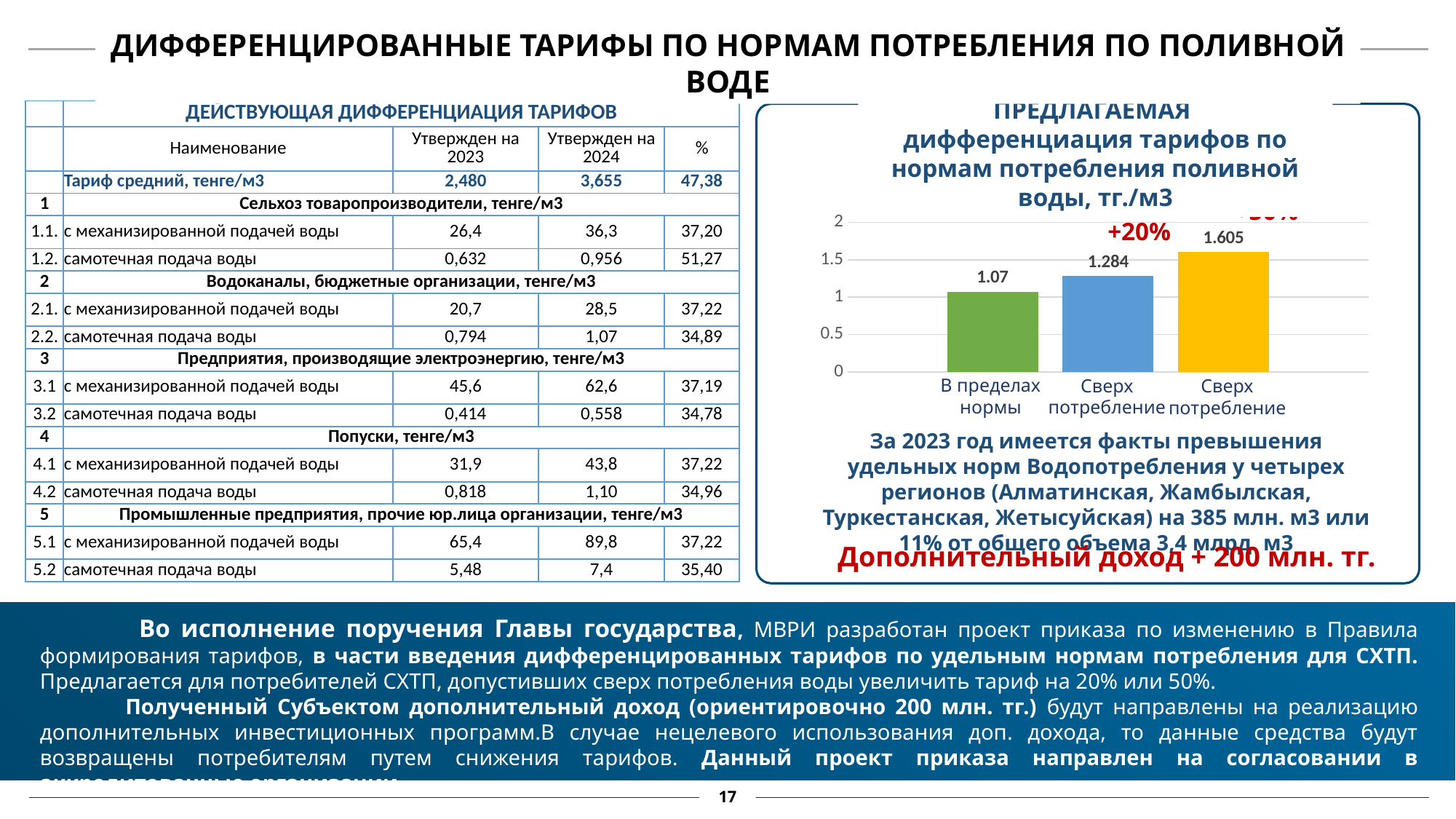
Which is larger: the middle bar or the "В пределах нормы" bar? the middle bar What is the difference between the rightmost bar (1.605) and the "В пределах нормы" bar (1.07)? 0.535 What is the value of the bar labelled "В пределах нормы"? 1.07 What is the value of the rightmost (yellow) bar in the chart? 1.605 What is the value of the middle (blue) bar in the chart? 1.284 What percentage increase is annotated in red above the middle bar of the chart? +20% What kind of chart is shown on the right side of the slide? bar chart How many bars are plotted in the chart? 3 Which bar has the lowest value in the chart? В пределах нормы What is the difference between the middle bar (1.284) and the "В пределах нормы" bar (1.07)? 0.214 Which bar has the highest value in the chart? the rightmost "Сверх потребление" bar (1.605) Do the bar values rise or fall from left to right across the chart? rise